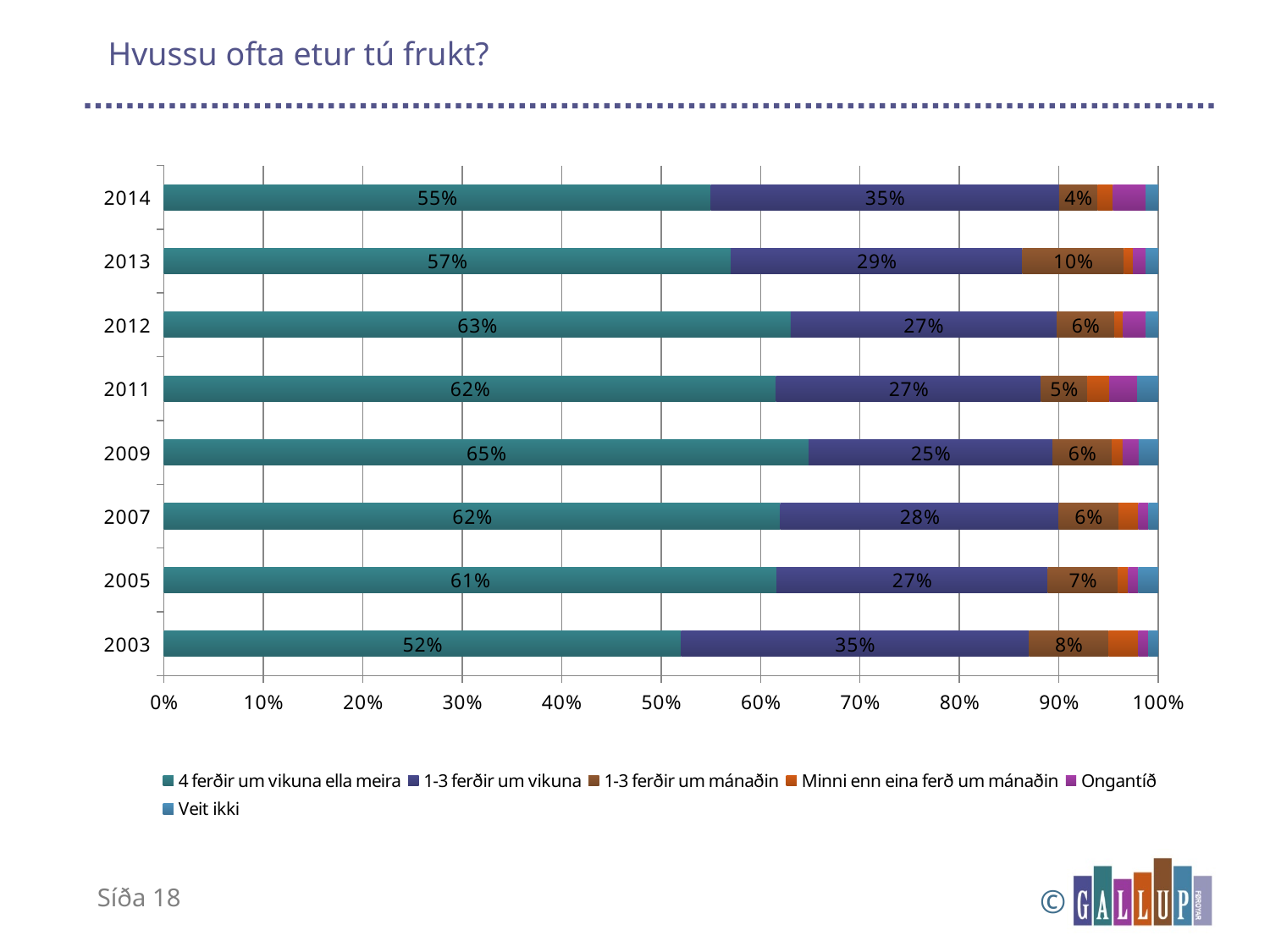
How many years are shown on the chart? 8 Which is larger: the "1-3 ferðir um vikuna" value for 2013 or for 2007? 2013 Is the value for "4 ferðir um vikuna ella meira" in 2011 greater or less than 60%? greater What kind of chart is shown on the slide? Stacked bar chart What is the difference between the "4 ferðir um vikuna ella meira" values for 2012 and 2014? 8% What is the value for "4 ferðir um vikuna ella meira" in 2014? 55% What is the value for "1-3 ferðir um vikuna" in 2003? 35% How many series does the legend list? 6 Which year has the highest value for "4 ferðir um vikuna ella meira"? 2009 What is the value for "1-3 ferðir um mánaðin" in 2013? 10% What is the title of the slide? Hvussu ofta etur tú frukt? Which year has the lowest value for "4 ferðir um vikuna ella meira"? 2003